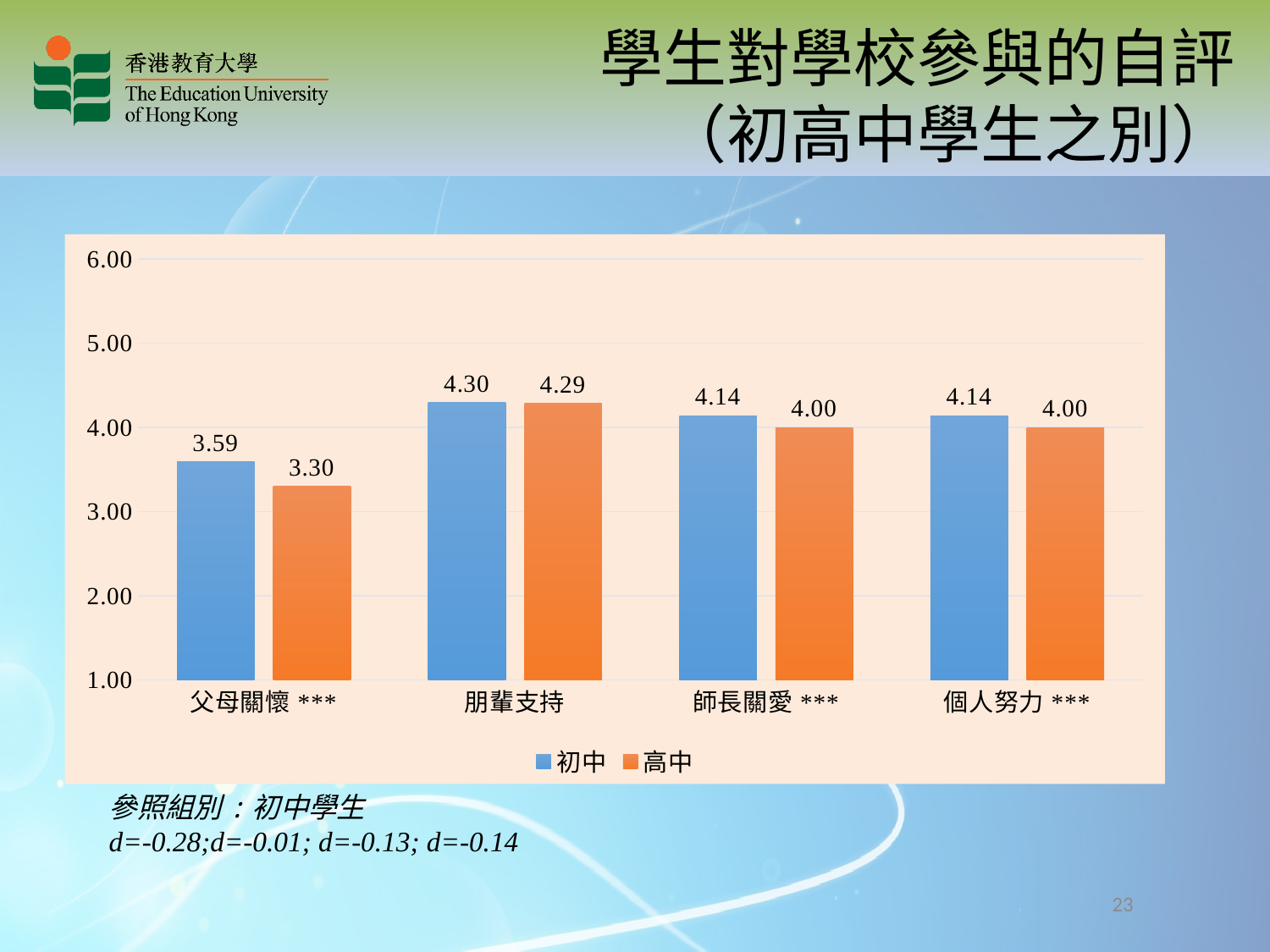
Which category has the lowest value for 高中? 父母關懷 *** What is the value for 高中 in the 朋輩支持 category? 4.29 Is the value for 高中 in the 父母關懷 *** category greater or less than 4.00? less How many series does the legend list? 2 What kind of chart is shown on the slide? bar chart What is the value for 初中 in the 父母關懷 *** category? 3.59 What is the value for 高中 in the 師長關愛 *** category? 4.00 In the 師長關愛 *** category, which series has the larger value, 初中 or 高中? 初中 What is the difference between the 初中 and 高中 values in the 父母關懷 *** category? 0.29 How many categories are shown on the x axis? 4 What is the difference between the 初中 and 高中 values in the 個人努力 *** category? 0.14 Which category has the highest value for 初中? 朋輩支持